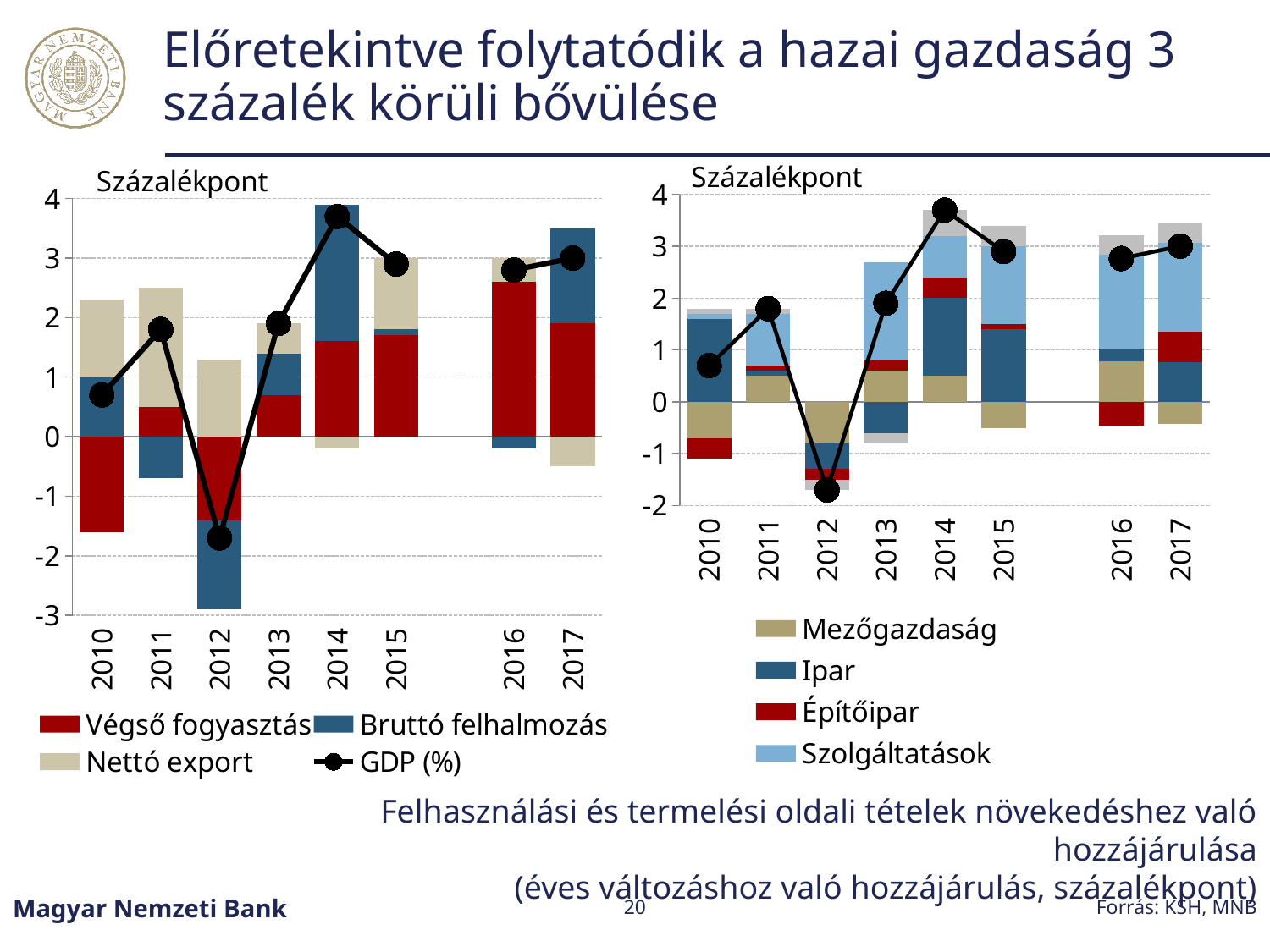
Which series is shown in light blue in the legend of the right chart? Szolgáltatások On the left chart, which year has the higher GDP (%) value, 2010 or 2011? 2011 On the left chart, is the GDP (%) value for 2014 greater or less than 3? greater How many series does the legend of the left chart list? 4 How many years are shown on the x axis of the right chart? 8 On the right chart, which year has the higher GDP (%) value, 2014 or 2015? 2014 On the left chart, in which year is the GDP (%) line at its highest? 2014 What kind of chart is the right chart? combination stacked bar and line chart On the left chart, is the GDP (%) value for 2012 greater or less than -1? less On the right chart, is the GDP (%) value for 2010 greater or less than 1? less On the left chart, in which year is the GDP (%) line at its lowest? 2012 On the right chart, does the GDP (%) line rise or fall from 2012 to 2014? rise